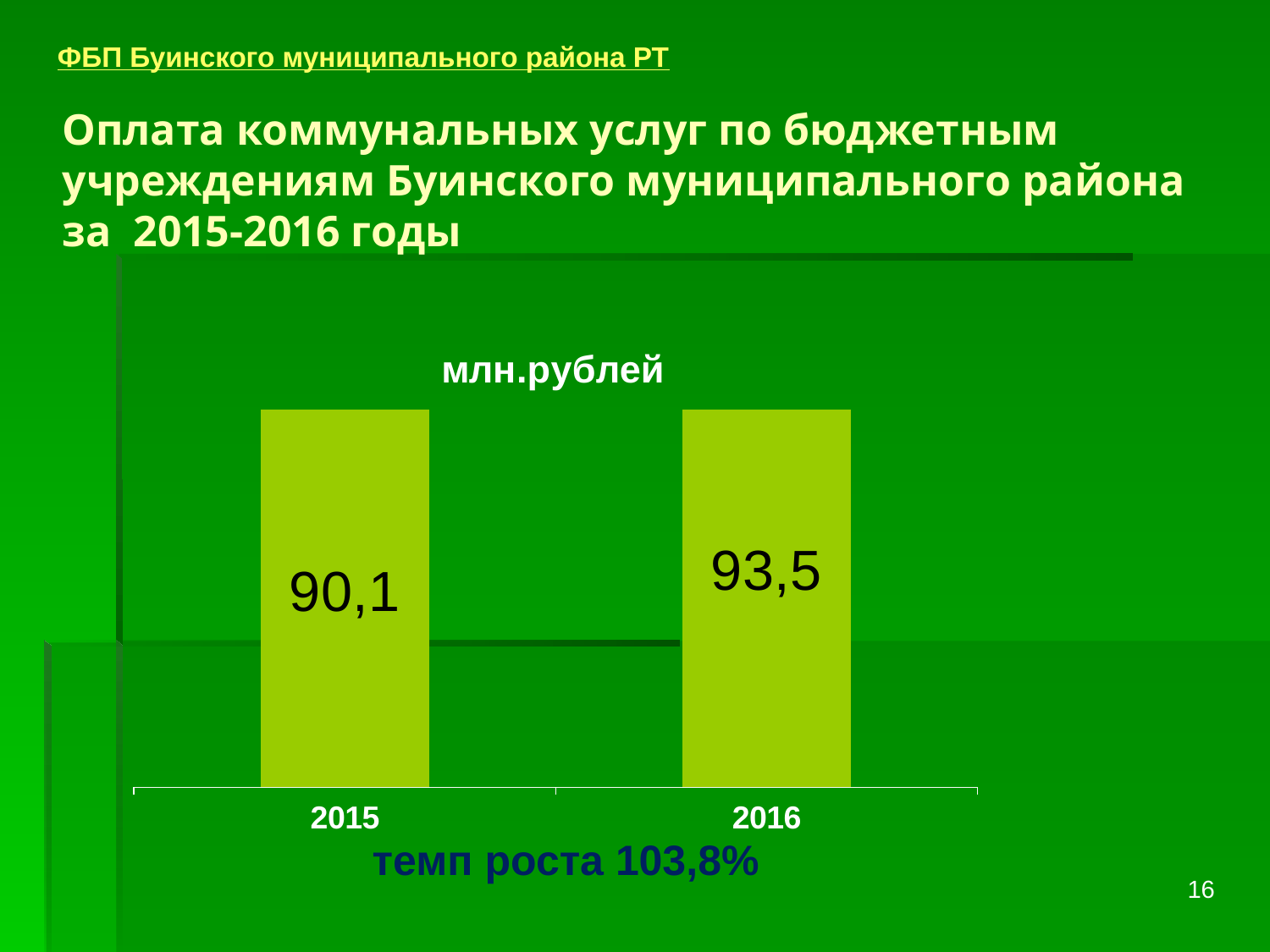
What is the value for 2015? 90,1 What kind of chart is shown on the slide? bar chart How many bars are shown in the chart? 2 What is the value for 2016? 93,5 What unit is shown above the chart? млн.рублей What growth rate (темп роста) is stated below the chart? 103,8% What is the difference between the values for 2016 and 2015? 3,4 Which year has the highest value? 2016 Do the values rise or fall from 2015 to 2016? rise Which year has the lowest value? 2015 Which is larger, the value for 2015 or the value for 2016? 2016